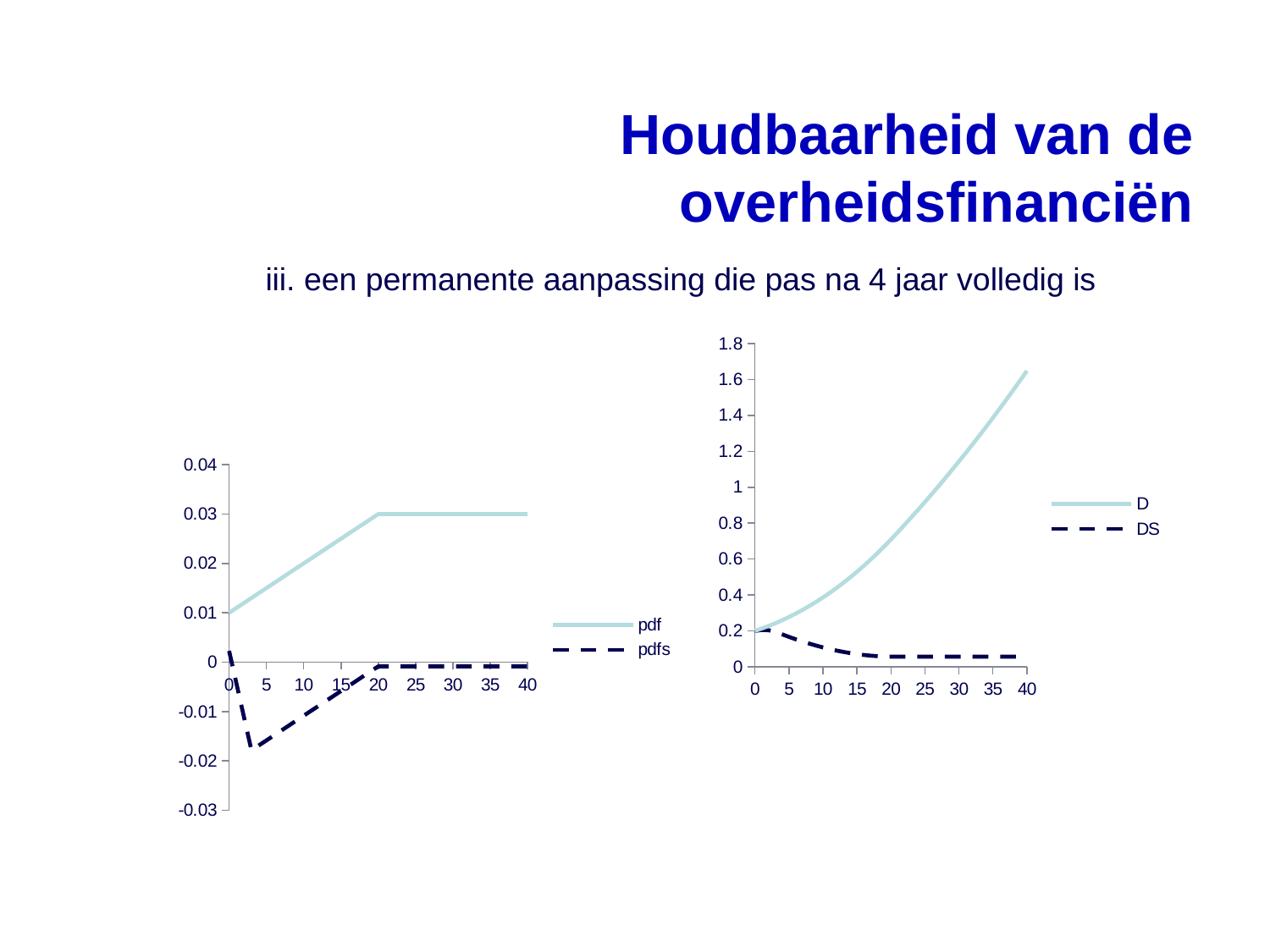
In the right chart, which series has the larger value at x = 40, D or DS? D What kind of chart is the left chart with the pdf and pdfs series? line chart In the left chart, what is the value of pdf at x = 0? 0.01 How many series does the legend of the left chart list? 2 In the left chart, is the value of pdfs at x = 5 greater or less than -0.01? less In the left chart, which series is drawn with a dashed line? pdfs How many series does the legend of the right chart list? 2 In the right chart, is the value of D at x = 40 greater or less than 1.4? greater What are the legend entries of the right chart? D and DS In the left chart, what value does the pdf series hold from x = 20 to x = 40? 0.03 In the right chart, is the value of DS at x = 40 greater or less than 0.2? less In the right chart, does the D series rise or fall as the x axis goes from 0 to 40? rise